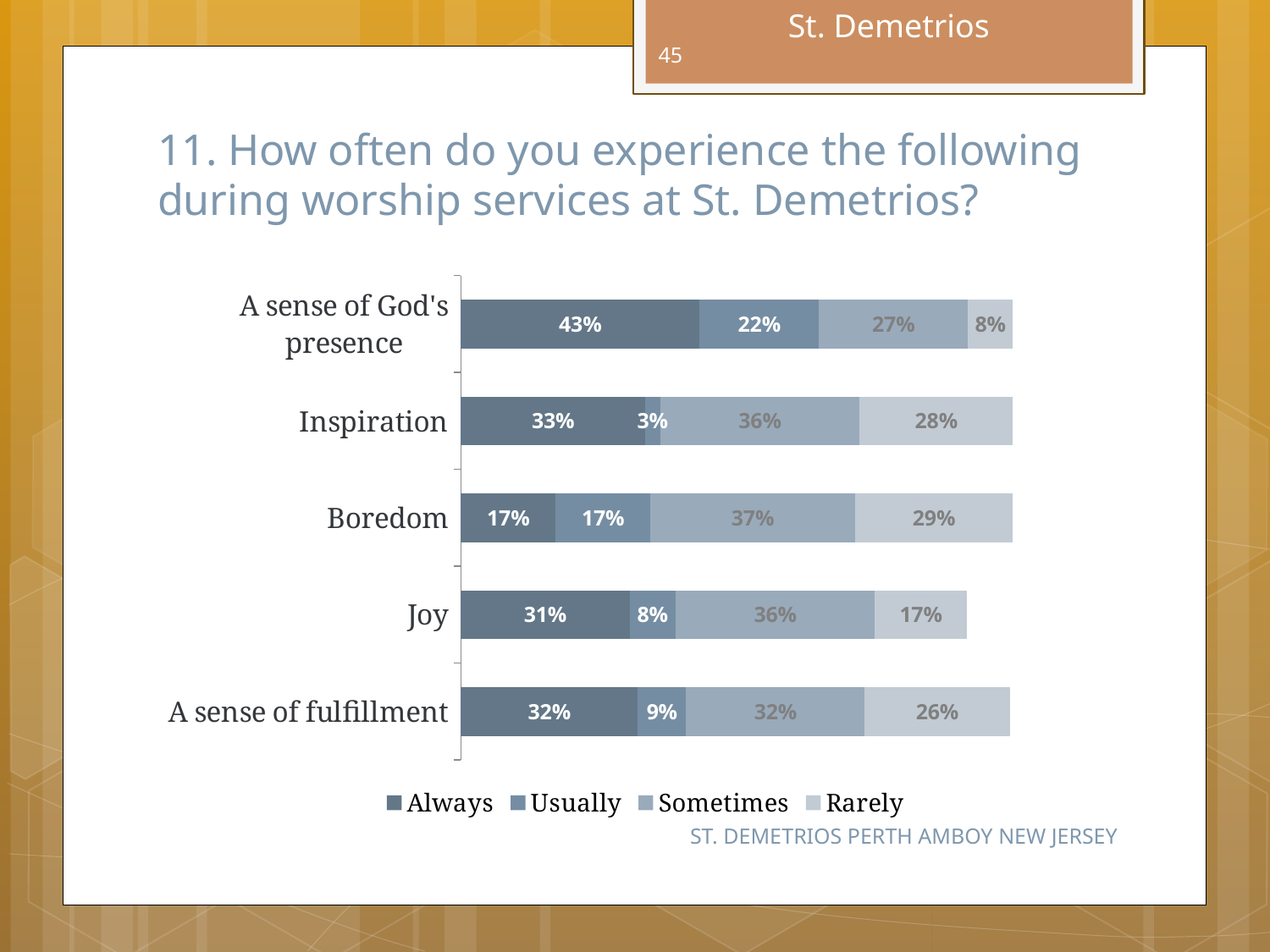
Which is larger: the 'Rarely' value for Boredom or the 'Rarely' value for Joy? Boredom What kind of chart is shown on the slide? Stacked bar chart What percentage of respondents said they 'Always' experience a sense of God's presence during worship services? 43% Which category has the highest 'Always' value? A sense of God's presence How many series does the legend list? 4 What is the 'Rarely' value for Inspiration? 28% What is the 'Usually' value for Joy? 8% What is the difference between the 'Always' values for A sense of God's presence and Boredom? 26% What is the 'Sometimes' value for Boredom? 37% How many categories are shown on the chart? 5 Which category has the lowest 'Always' value? Boredom What is the total of the stacked bar for Joy? 92%